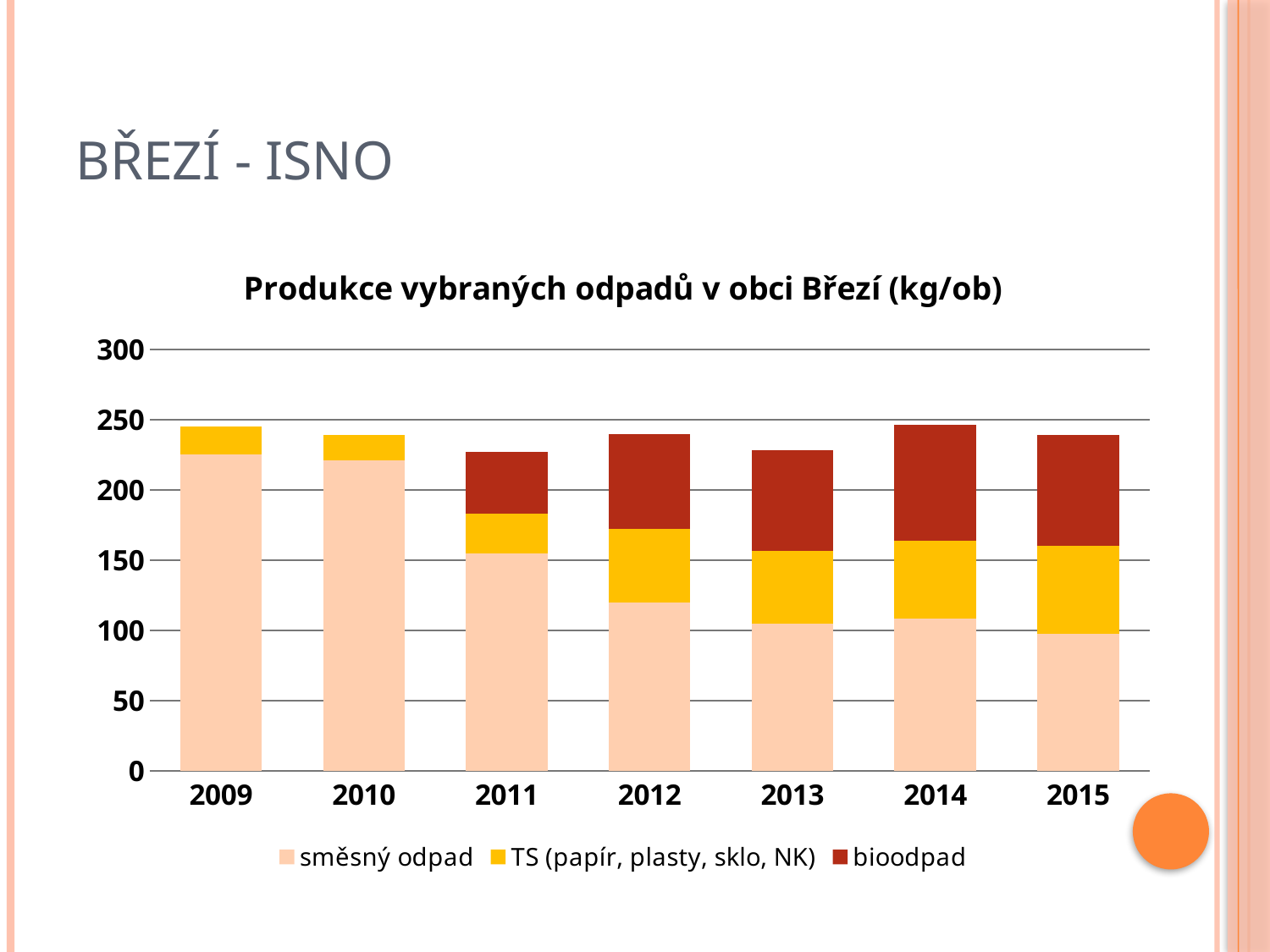
Is the směsný odpad value for 2009 greater or less than 200? greater Which series is shown in dark red in the chart? bioodpad Is the total height of the 2013 bar greater or less than 200? greater Which year has the larger směsný odpad segment, 2009 or 2015? 2009 Does the směsný odpad segment generally rise or fall from 2009 to 2015? fall Is the směsný odpad value for 2012 greater or less than 150? less Which year has the larger bioodpad segment, 2011 or 2014? 2014 What is the title of the chart? Produkce vybraných odpadů v obci Březí (kg/ob) What kind of chart is shown on the slide? stacked bar chart How many years are shown on the x axis of the chart? 7 How many series does the chart's legend list? 3